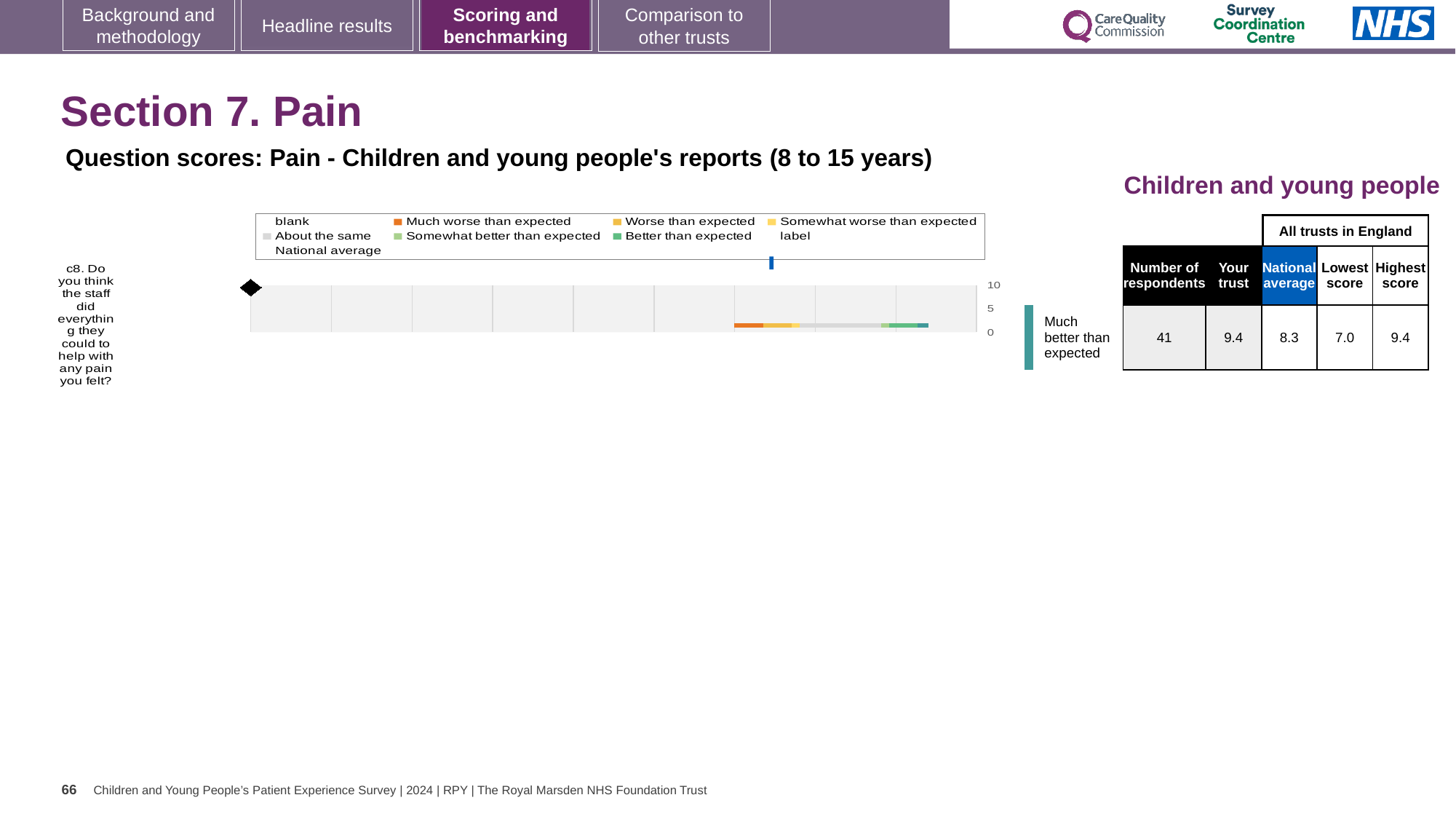
Which legend entry is shown in orange? Much worse than expected In the table next to the chart, what is the difference between the highest score and the lowest score for question c8? 2.4 Which question is plotted on the chart? c8. Do you think the staff did everything they could to help with any pain you felt? In the table next to the chart, which is larger for question c8: the 'Your trust' score or the national average? Your trust What kind of chart is shown on the slide? bar chart What is the highest value shown on the chart's numeric axis? 10 How many entries does the chart legend list? 9 How many question categories are plotted on the chart? 1 What rating label is shown beside the chart for question c8? Much better than expected In the table next to the chart, how many respondents answered question c8? 41 In the table next to the chart, what is the national average score for question c8? 8.3 In the table next to the chart, what is the 'Your trust' score for question c8? 9.4